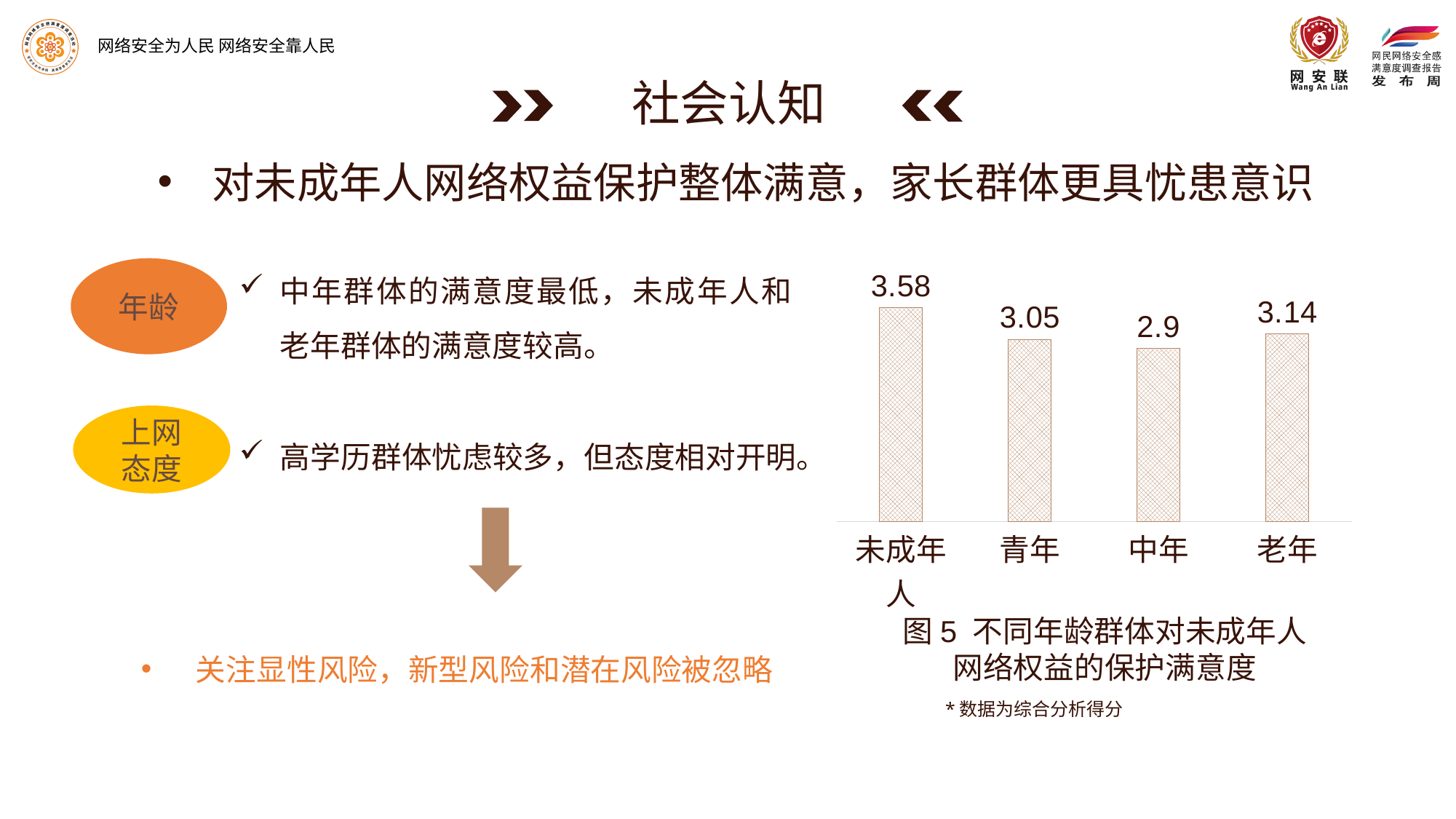
What is the value for 老年 in the chart? 3.14 What is the value for 中年 in the chart? 2.9 What is the value for 未成年人 in the chart? 3.58 Which age group has the lowest value in the chart? 中年 Which age group has the highest value in the chart? 未成年人 What is the difference between the values for 未成年人 and 中年? 0.68 What is the difference between the values for 老年 and 青年? 0.09 How many age groups are shown in the chart? 4 What is the value for 青年 in the chart? 3.05 What is the title of the chart on the slide? 图5 不同年龄群体对未成年人网络权益的保护满意度 Which is larger, the value for 青年 or the value for 老年? 老年 What kind of chart is shown on the slide? Bar chart